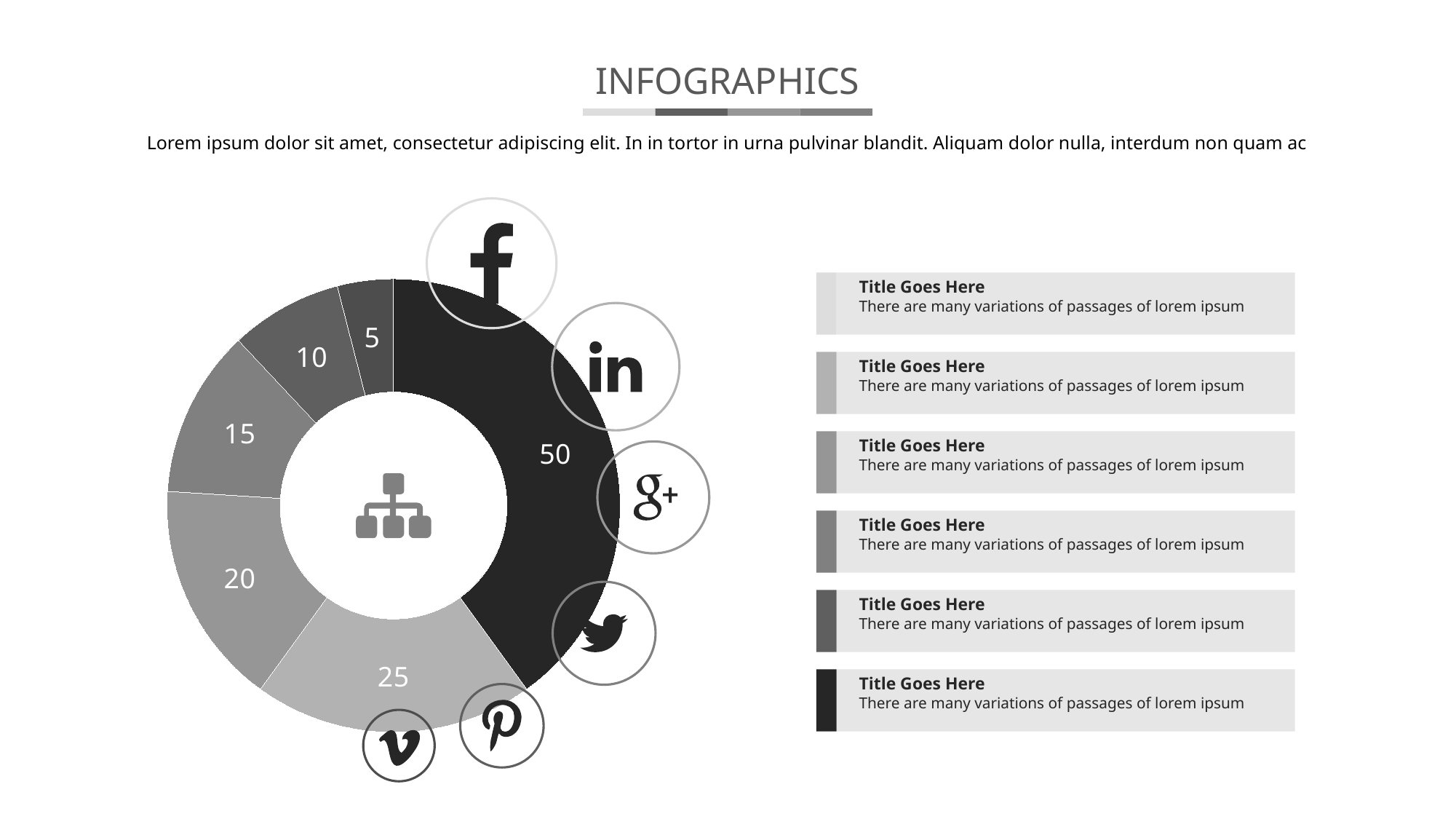
What is the difference between the largest and smallest values on the donut chart? 45 What is the smallest value shown on the donut chart? 5 Which is larger on the donut chart, the slice labelled 25 or the slice labelled 20? 25 What is the largest value shown on the donut chart? 50 What is the title at the top of the slide? INFOGRAPHICS What kind of chart is shown on the slide? Donut chart What colour is the largest slice of the donut chart? Black What share of the donut chart's total does the largest slice (50) represent? 40% What share of the donut chart's total does the smallest slice (5) represent? 4% What is the sum of all the values shown on the donut chart? 125 What is the difference between the slices labelled 25 and 15 on the donut chart? 10 How many slices does the donut chart have? 6